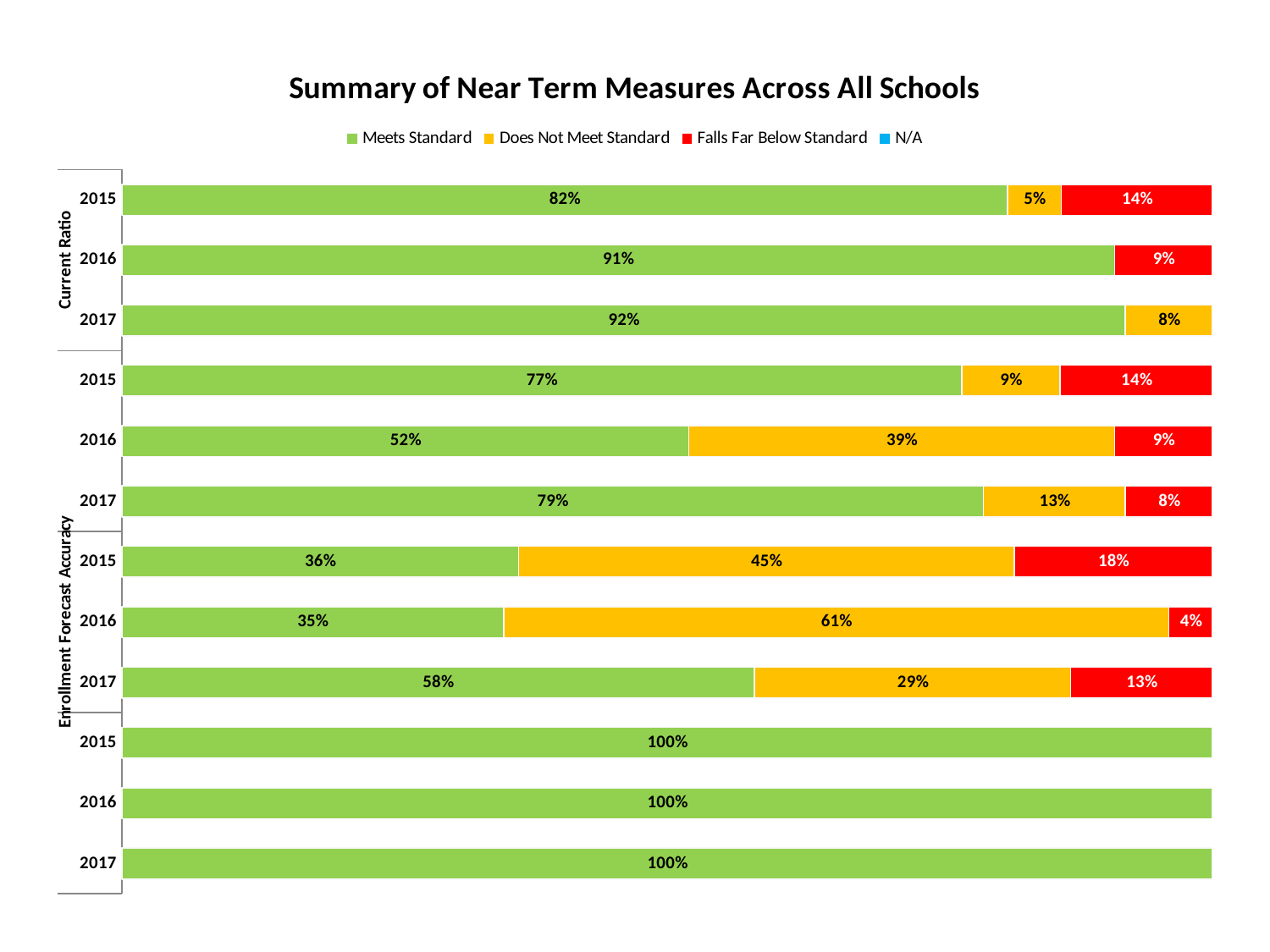
For Current Ratio, which year has the higher Meets Standard percentage, 2016 or 2017? 2017 What percentage Meets Standard is shown on the bottom three bars (2015, 2016 and 2017)? 100% For Current Ratio in 2017, what percentage Does Not Meet Standard? 8% What is the largest Does Not Meet Standard value shown on any bar? 61% For Current Ratio in 2016, what percentage Falls Far Below Standard? 9% What kind of chart is shown on the slide? Stacked bar chart For Current Ratio in 2015, what is the difference between the Falls Far Below Standard share and the Does Not Meet Standard share? 9 percentage points For Current Ratio, does the Meets Standard percentage rise or fall from 2015 to 2017? Rise For Current Ratio in 2015, what percentage Meets Standard? 82% What is the title of the chart? Summary of Near Term Measures Across All Schools How many bars are plotted on the chart? 12 How many series does the legend list? 4